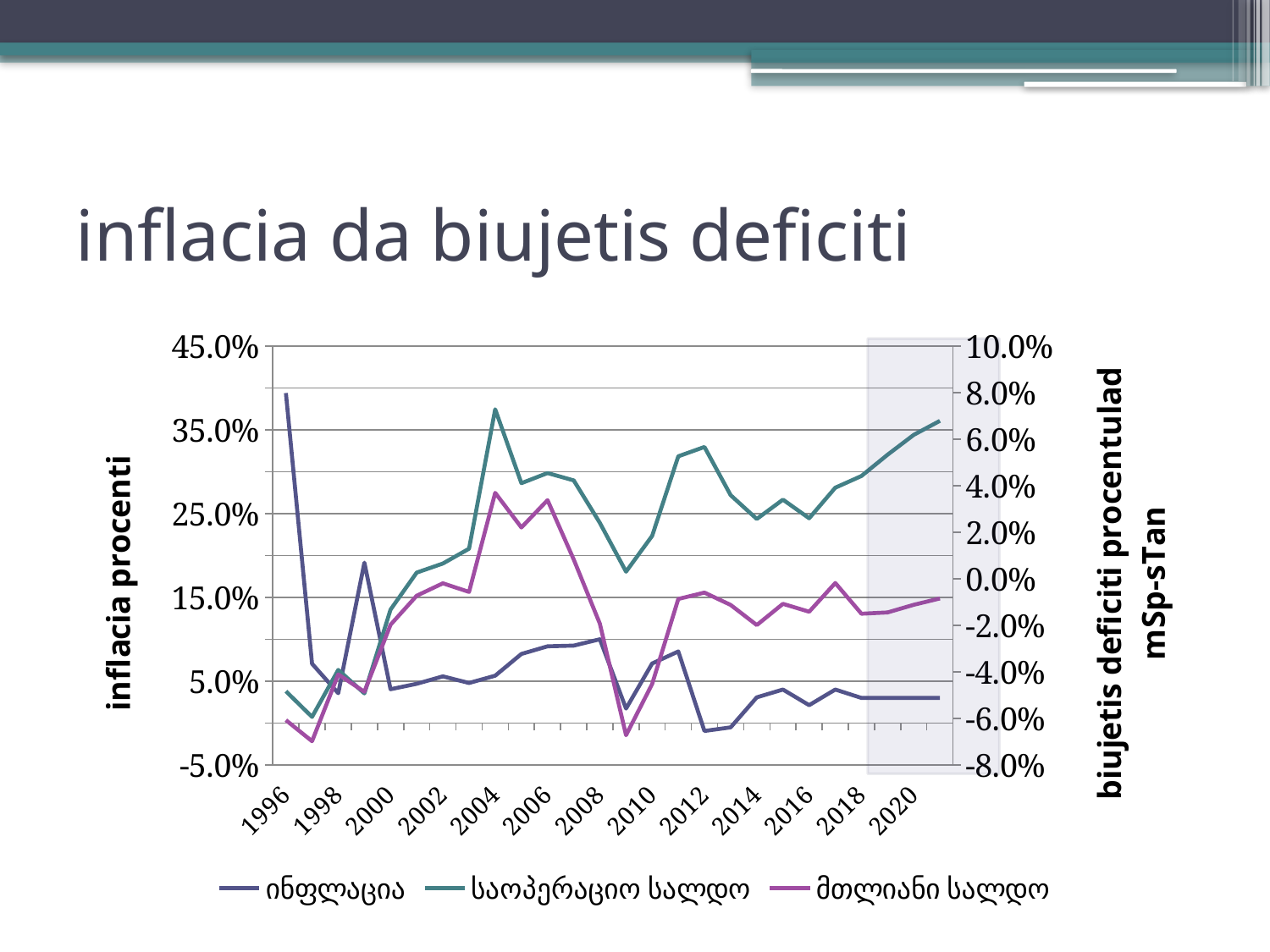
What is the title of the left vertical axis? inflacia procenti Is the ინფლაცია value for 1999 greater or less than 15.0%? greater Is the მთლიანი სალდო value for 2009 greater or less than -4.0%? less Is the ინფლაცია value for 2013 greater or less than 5.0%? less What kind of chart is shown on the slide? line chart Does the საოპერაციო სალდო series rise or fall from 2016 to the end of the chart? rise In which year is the ინფლაცია series at its highest? 1996 What is the title of the right vertical axis? biujetis deficiti procentulad mSp-sTan Which is larger in 2004, the საოპერაციო სალდო value or the მთლიანი სალდო value? საოპერაციო სალდო How many series does the legend list? 3